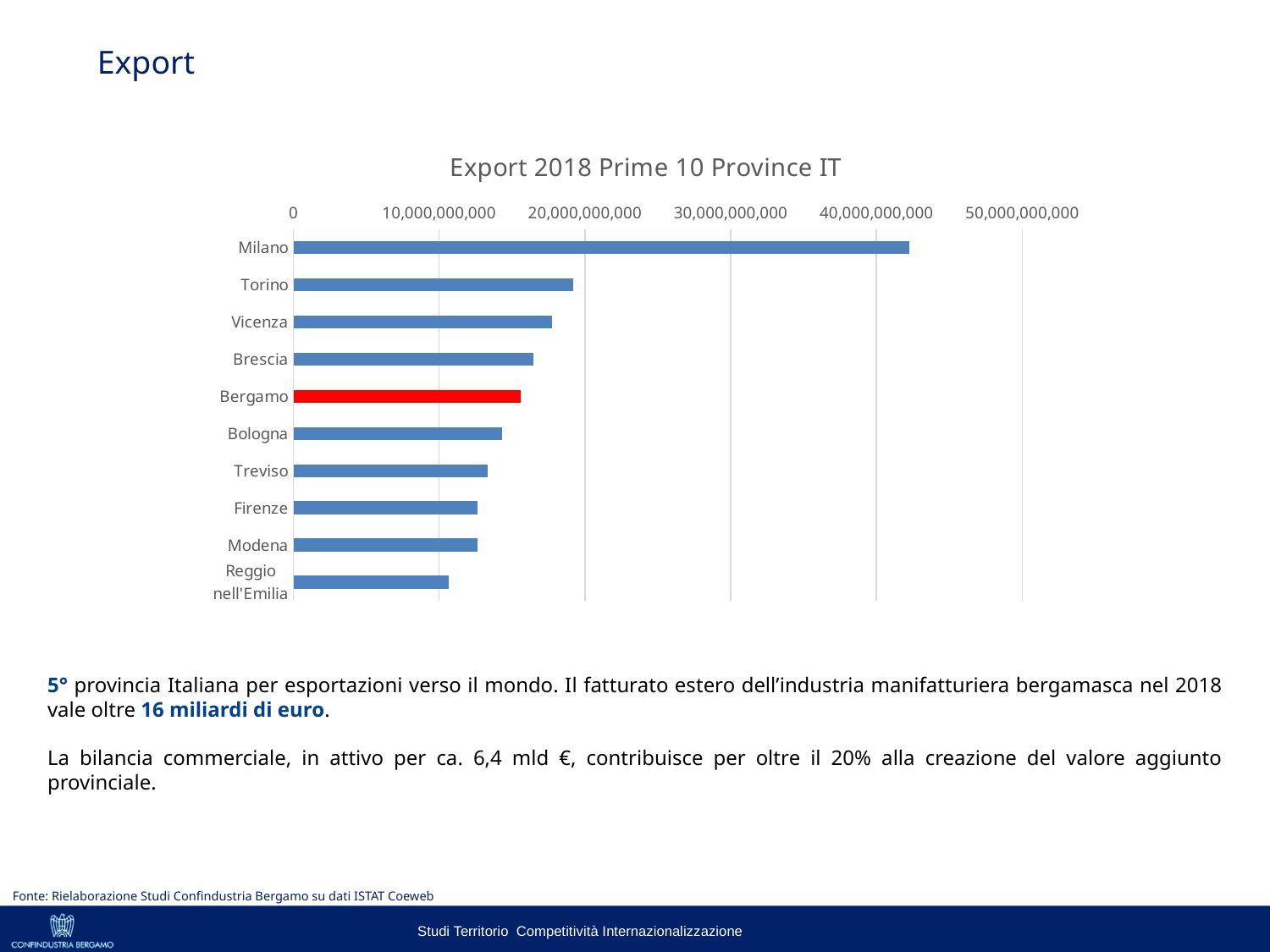
Is the value for Bergamo greater or less than 10,000,000,000? greater What is the title of the chart? Export 2018 Prime 10 Province IT What kind of chart is shown on the slide? bar chart Is the value for Bologna greater or less than 20,000,000,000? less Which has a larger export value, Milano or Torino? Milano Which province has the lowest export value in the chart? Reggio nell'Emilia Which province has the highest export value in the chart? Milano Is the value for Milano greater or less than 40,000,000,000? greater How many provinces are shown in the chart? 10 Which province's bar is highlighted in red? Bergamo Which has a larger export value, Torino or Bergamo? Torino